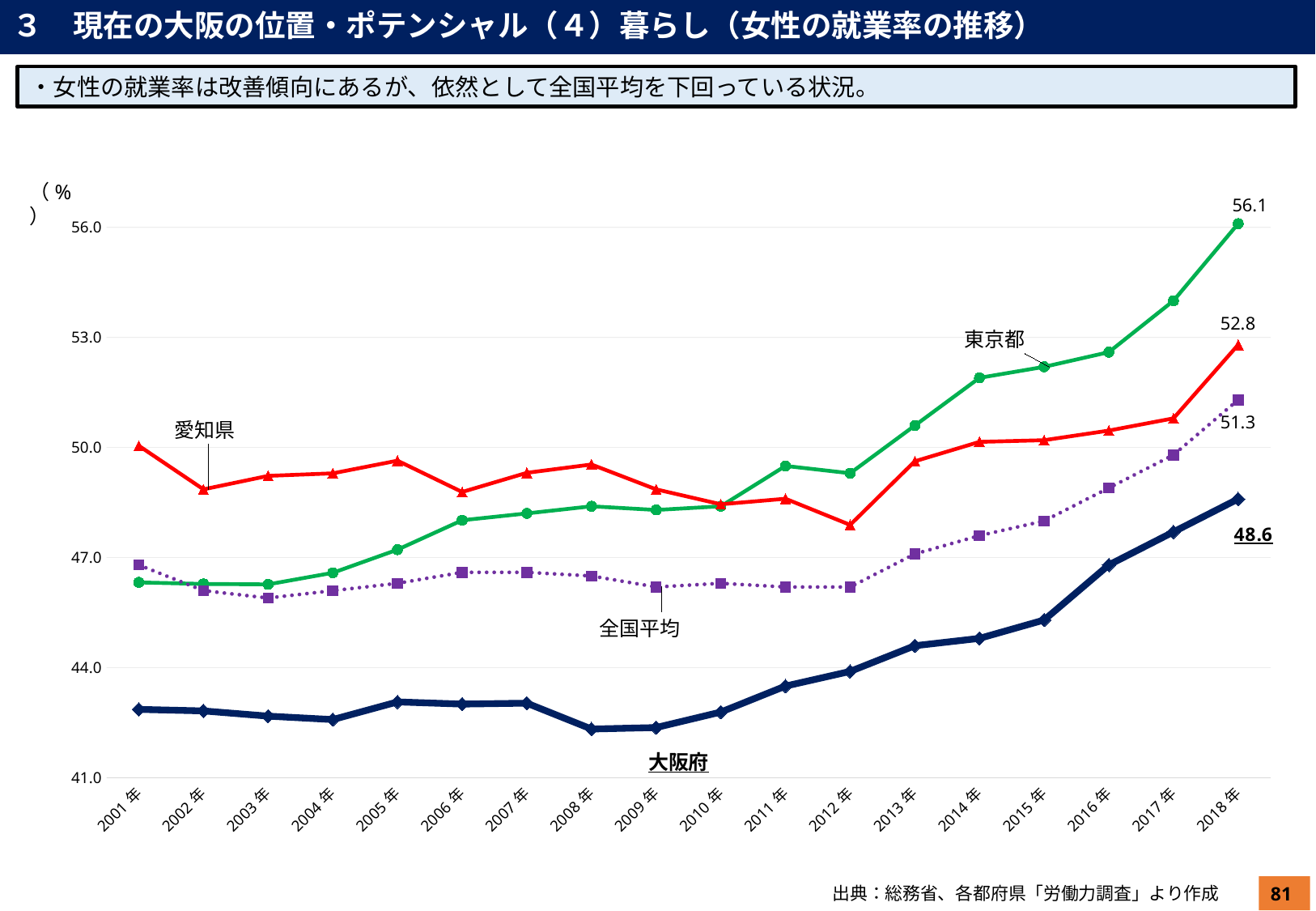
Is the value for 大阪府 in 2001年 greater or less than 44.0? less What is the difference between the 2018年 values for 東京都 and 大阪府? 7.5 What is the value for 大阪府 in 2018年? 48.6 What type of chart is shown on the slide? line chart What is the value for 東京都 in 2018年? 56.1 What is the value for 愛知県 in 2018年? 52.8 Does the value for 大阪府 rise or fall from 2012年 to 2018年? rise Which series has the lowest value in 2018年? 大阪府 How many years are shown on the x axis? 18 What is the value for 全国平均 in 2018年? 51.3 What is the difference between the 2018年 values for 全国平均 and 大阪府? 2.7 Which series has the highest value in 2018年? 東京都